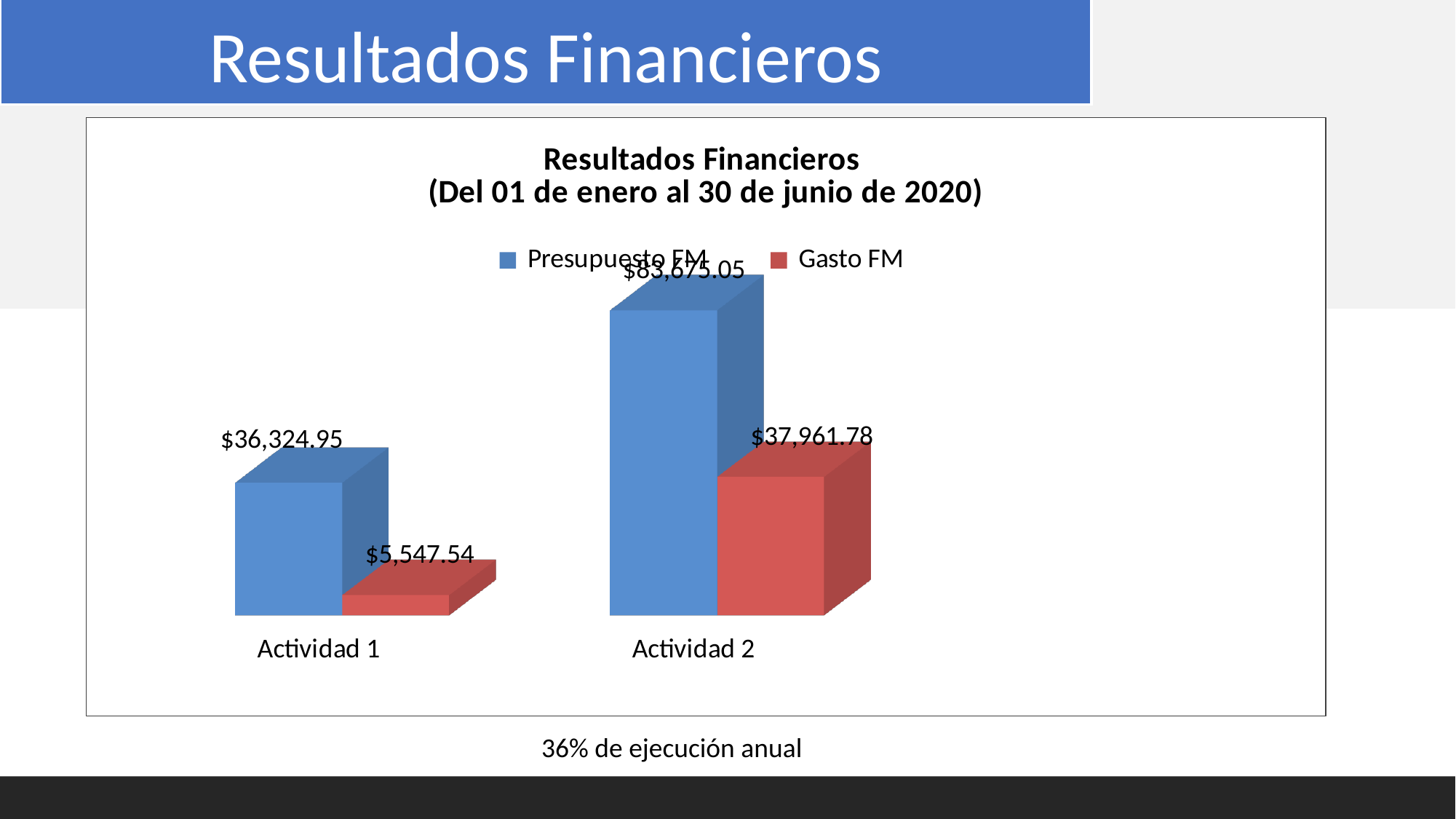
Which activity has the higher Presupuesto FM? Actividad 2 What is the Gasto FM value for Actividad 1? $5,547.54 What is the Presupuesto FM value for Actividad 1? $36,324.95 Does the Gasto FM value rise or fall from Actividad 1 to Actividad 2? Rise Which activity has the lowest Gasto FM? Actividad 1 How many activities (categories) are shown on the x axis? 2 For Actividad 1, which is larger: Presupuesto FM or Gasto FM? Presupuesto FM How much larger is the Gasto FM for Actividad 2 than for Actividad 1? $32,414.24 What is the difference between Presupuesto FM and Gasto FM for Actividad 1? $30,777.41 What kind of chart is shown on the slide? Bar chart What is the Gasto FM value for Actividad 2? $37,961.78 How many series does the legend list? 2